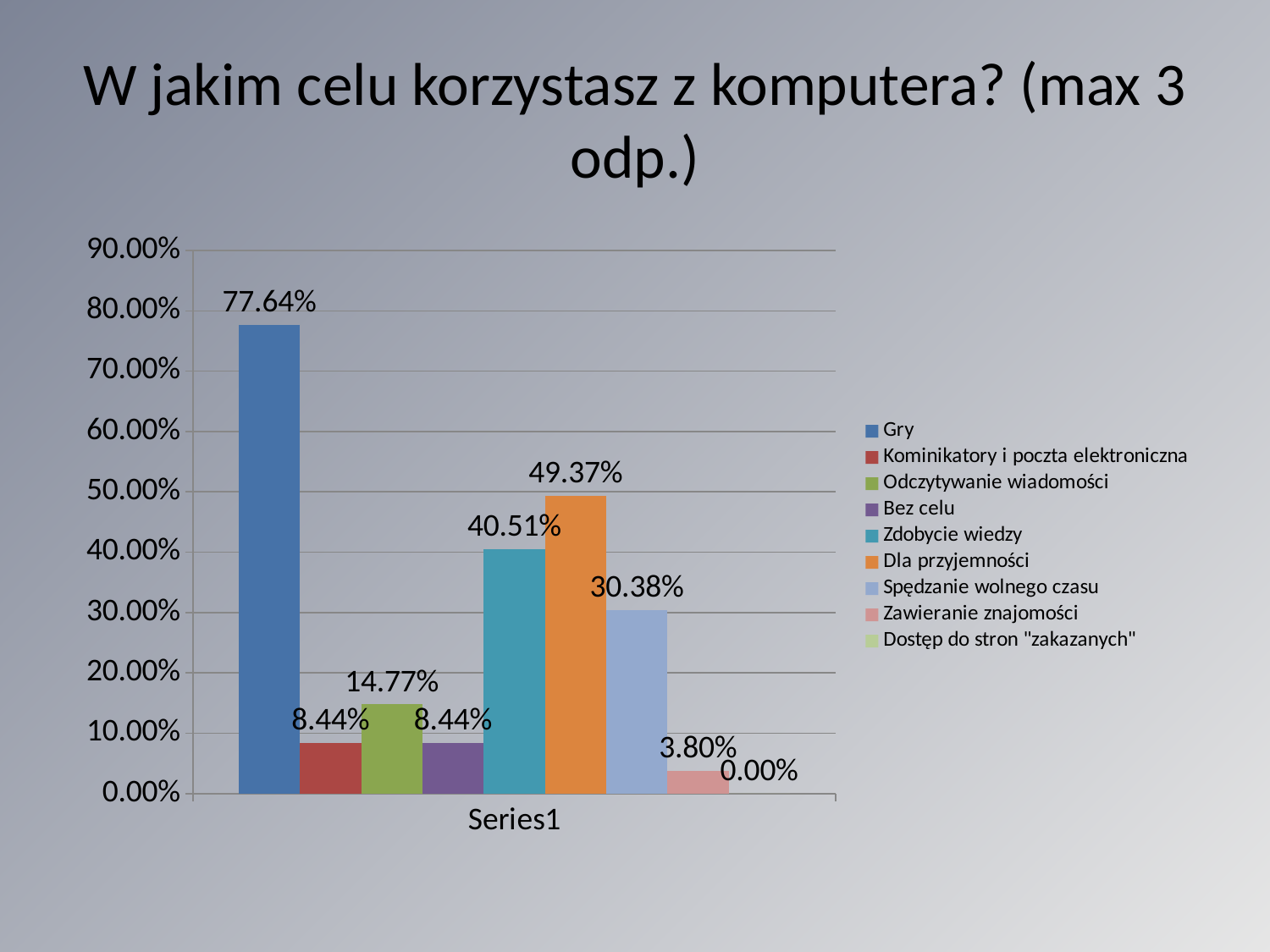
What is the difference between the values for Gry and Dla przyjemności? 28.27% What is the value for Zdobycie wiedzy? 40.51% What kind of chart is shown on the slide? Bar chart What is the value for Gry? 77.64% What is the value for Dla przyjemności? 49.37% What is the title of the slide? W jakim celu korzystasz z komputera? (max 3 odp.) How many entries does the legend list? 9 Which is larger, the value for Zdobycie wiedzy or the value for Spędzanie wolnego czasu? Zdobycie wiedzy What is the value for Zawieranie znajomości? 3.80% Which legend entry has the highest value? Gry What is the value for Dostęp do stron "zakazanych"? 0.00% Which legend entry has the lowest value? Dostęp do stron "zakazanych"